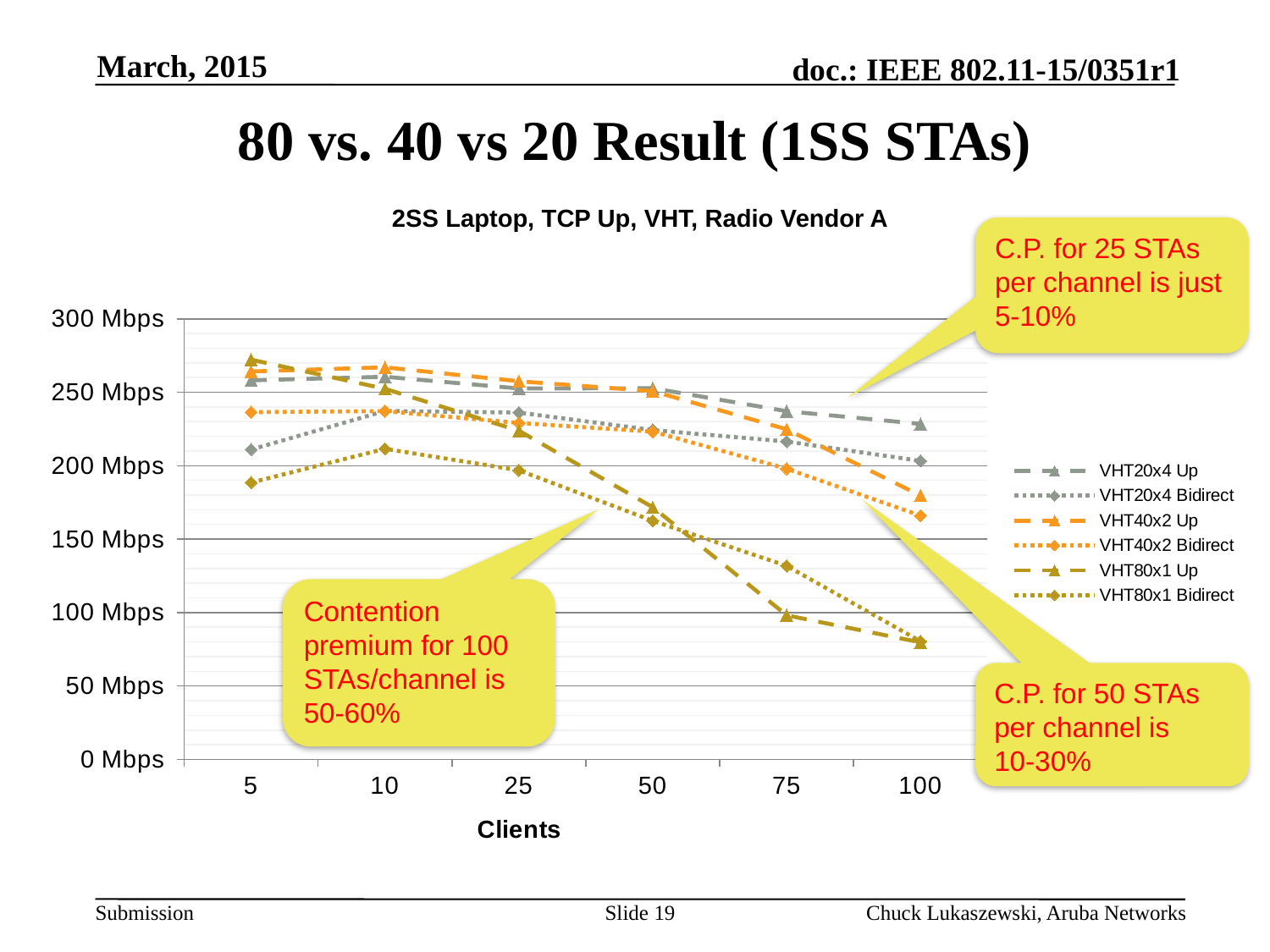
Is the value for VHT80x1 Up at 100 clients greater or less than 100 Mbps? less What kind of chart is shown on the slide? Line chart How many series does the legend list? 6 Does the VHT80x1 Up series rise or fall as the number of clients increases? Falls Is the value for VHT40x2 Bidirect at 100 clients greater or less than 150 Mbps? greater What is the label of the x axis? Clients At 100 clients, which is larger: VHT20x4 Up or VHT80x1 Up? VHT20x4 Up What is the title of the chart? 2SS Laptop, TCP Up, VHT, Radio Vendor A Is the value for VHT80x1 Bidirect at 5 clients greater or less than 200 Mbps? less How many client counts are plotted along the x axis? 6 Which series has the highest value at 100 clients? VHT20x4 Up